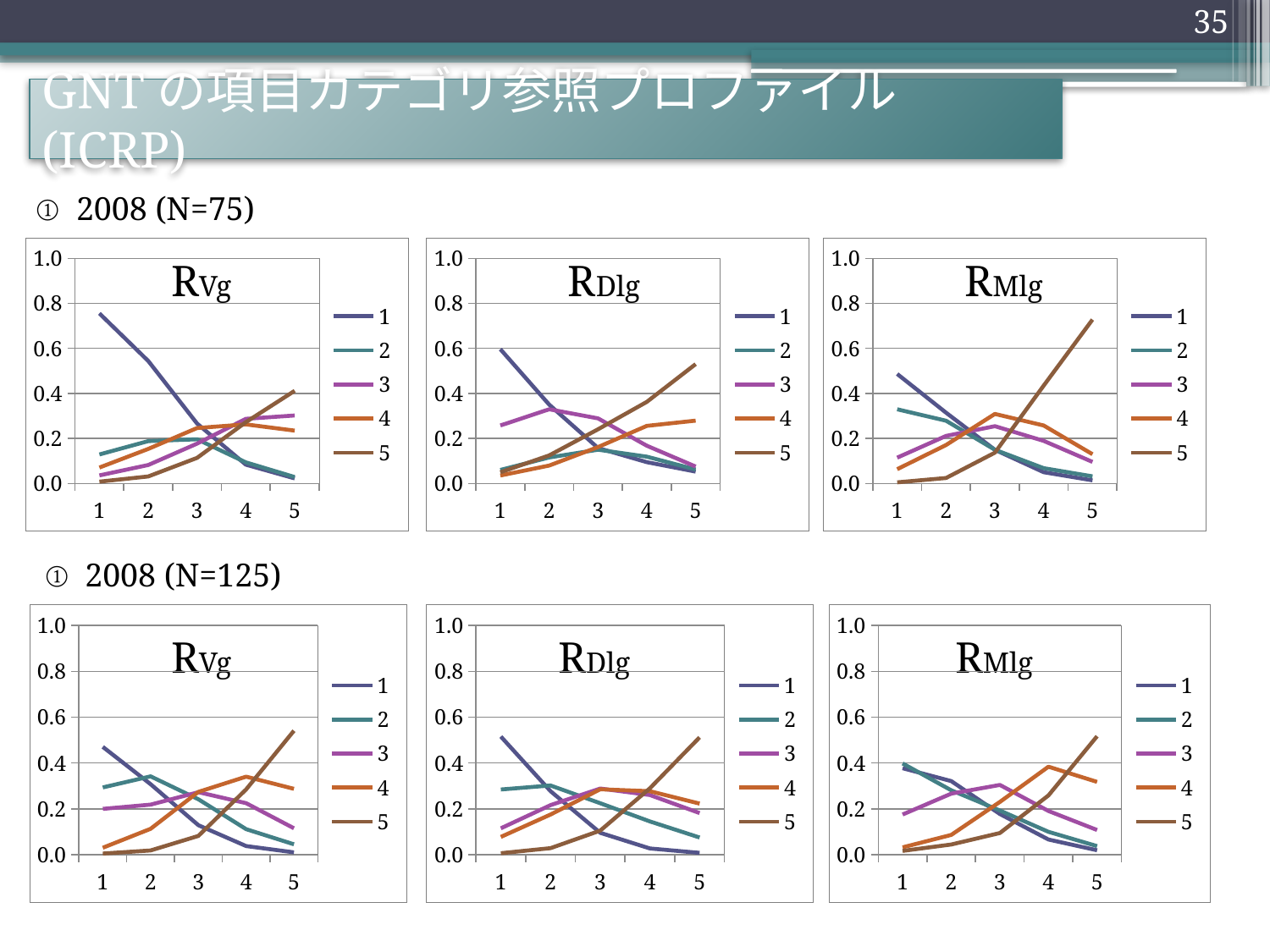
What is the title of the top-middle chart on the slide? RDlg What is the sample size label shown above the bottom row of charts? 2008 (N=125) How many points are plotted along the x axis in the bottom-right chart titled RMlg (2008, N=125)? 5 How many series does the legend list in the top-middle chart titled RDlg (2008, N=75)? 5 In the top-left chart titled RVg (2008, N=75), does series 1 rise or fall from x=1 to x=5? fall In the top-right chart titled RMlg (2008, N=75), does series 5 rise or fall from x=1 to x=5? rise In the bottom-left chart titled RVg (2008, N=125), is the value of series 5 at x=5 greater or less than 0.4? greater In the top-left chart titled RVg (2008, N=75), is the value of series 1 at x=1 greater or less than 0.6? greater In the bottom-right chart titled RMlg (2008, N=125), does series 1 rise or fall from x=1 to x=5? fall In the top-right chart titled RMlg (2008, N=75), is the value of series 5 at x=5 greater or less than 0.6? greater What kind of chart is the top-left chart titled RVg (2008, N=75)? line chart